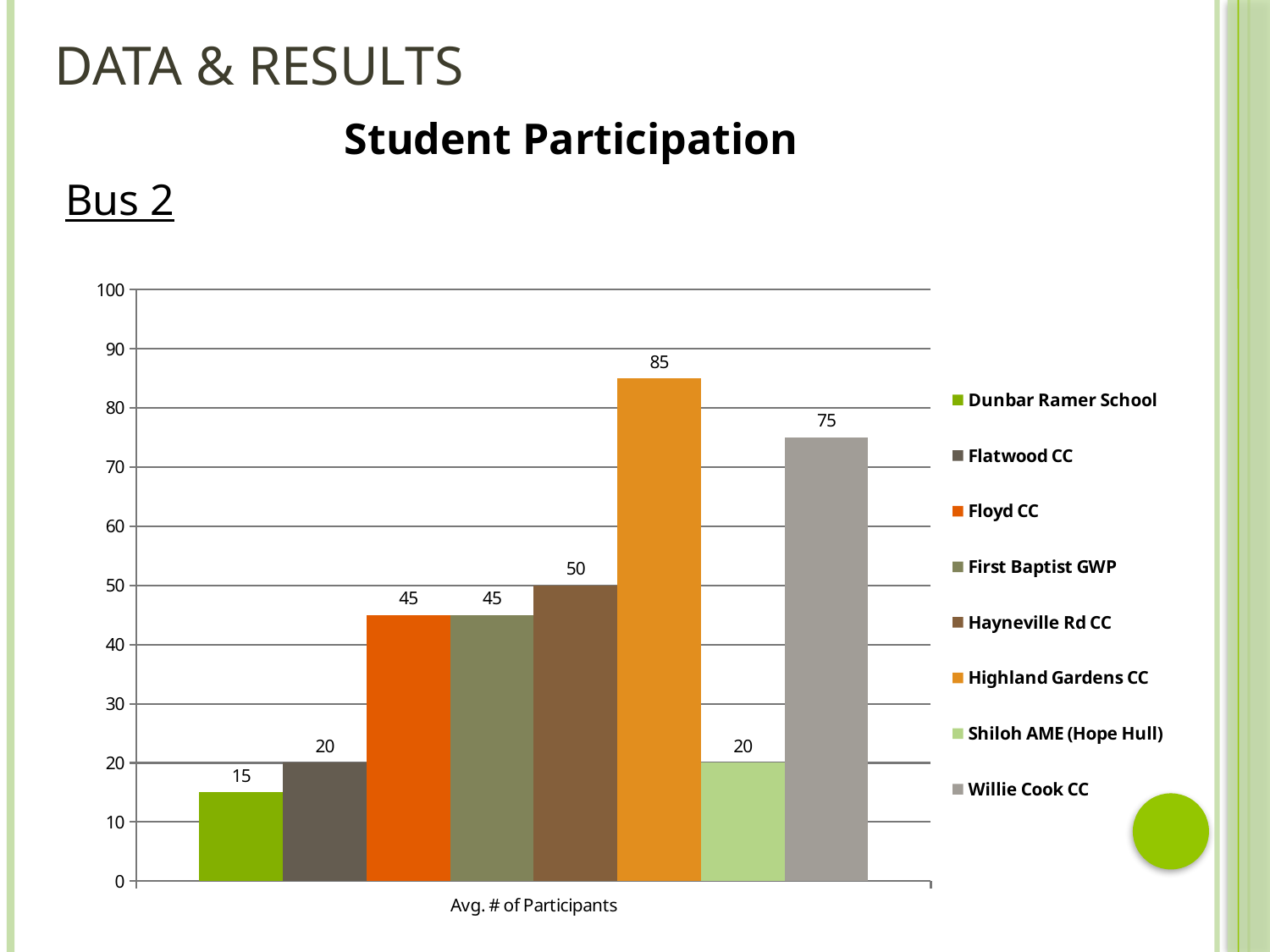
What kind of chart is shown on the slide? bar chart What is the average number of participants for Highland Gardens CC? 85 How many series does the legend list? 8 What is the label on the x axis of the chart? Avg. # of Participants Which series has the highest average number of participants? Highland Gardens CC What is the average number of participants for Willie Cook CC? 75 Which has a larger value, Hayneville Rd CC or Floyd CC? Hayneville Rd CC Is the value for Willie Cook CC greater or less than 70? greater What is the average number of participants for Dunbar Ramer School? 15 Which series has the lowest average number of participants? Dunbar Ramer School What is the difference between the values for Highland Gardens CC and Willie Cook CC? 10 Which series is shown in orange in the legend, with a value of 85? Highland Gardens CC